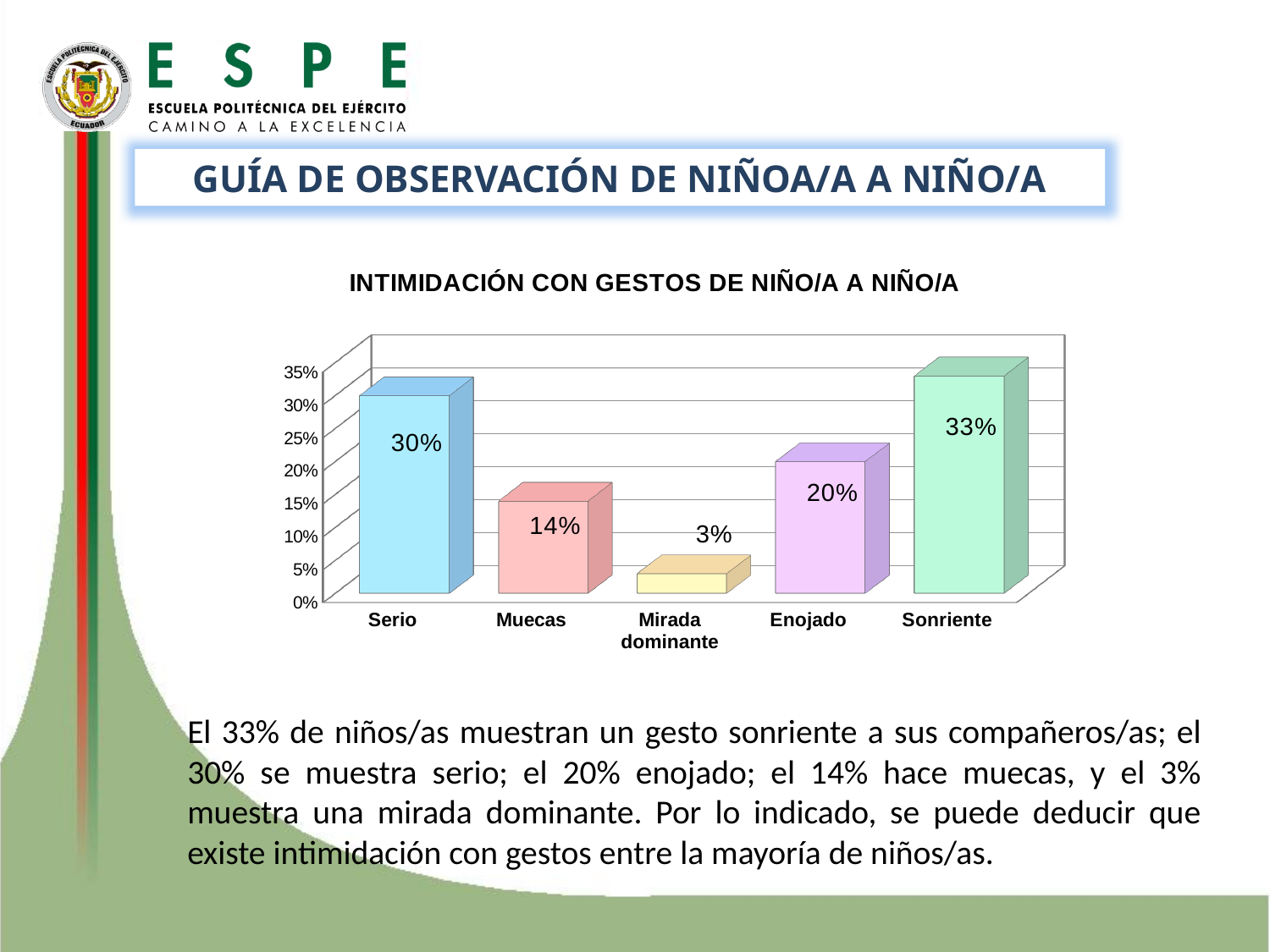
Which category has the lowest value? Mirada dominante What is the difference between the values for Enojado and Muecas? 6% What is the value for Mirada dominante? 3% What is the value for Enojado? 20% What is the title of the chart? INTIMIDACIÓN CON GESTOS DE NIÑO/A A NIÑO/A What kind of chart is shown? Bar chart What is the value for Serio? 30% How many categories are shown in the chart? 5 Which category has the highest value? Sonriente Which is larger, the value for Enojado or the value for Muecas? Enojado What is the difference between the values for Sonriente and Serio? 3% What is the value for Muecas? 14%